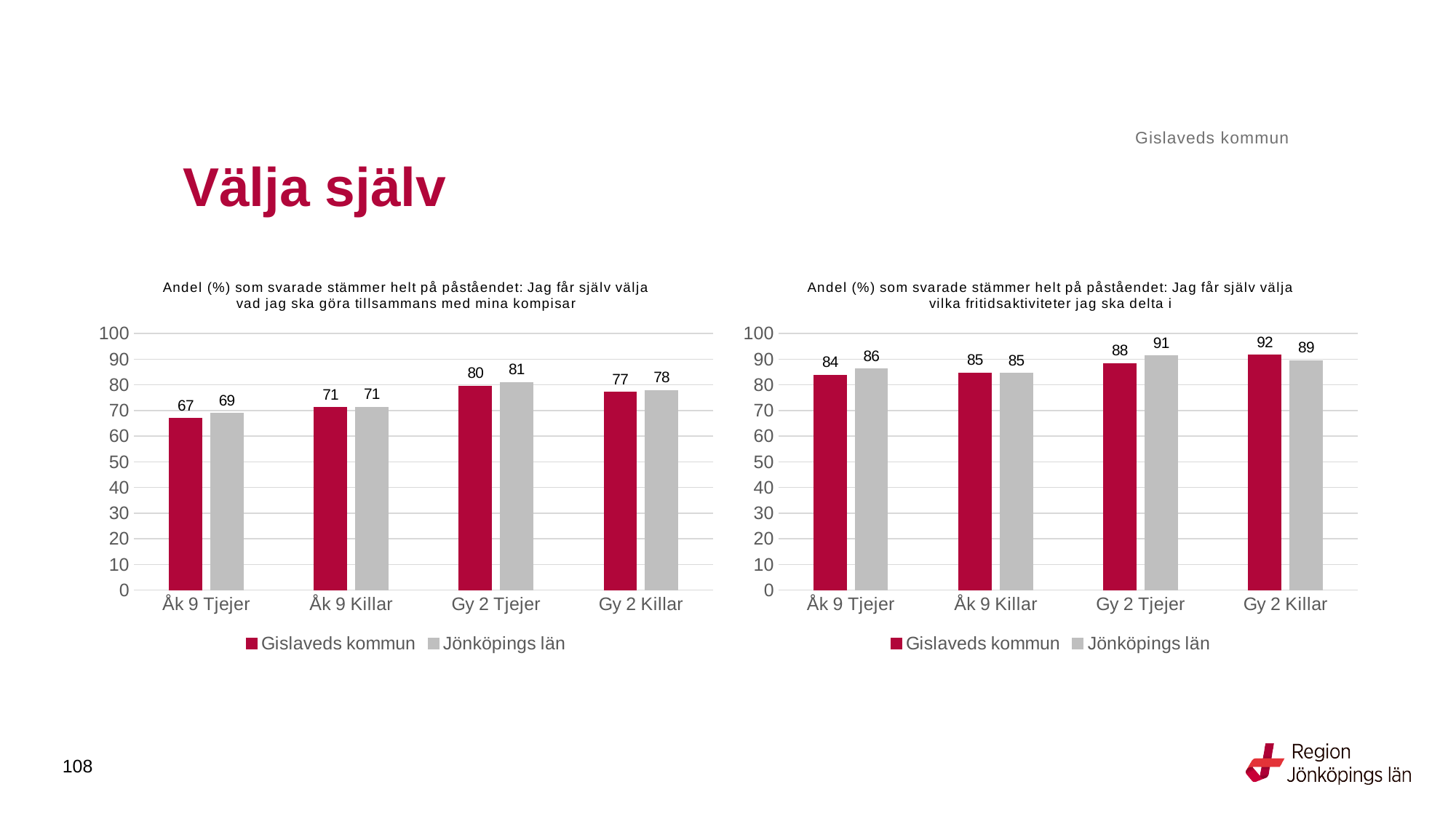
In the right chart (about choosing leisure activities), what is the value for Gislaveds kommun for Gy 2 Killar? 92 In the right chart (about choosing leisure activities), what is the difference between the Gislaveds kommun values for Gy 2 Killar and Åk 9 Tjejer? 8 In the right chart (about choosing leisure activities), what is the value for Jönköpings län for Åk 9 Tjejer? 86 How many categories are shown on the x axis of the left chart? 4 In the left chart (about choosing what to do with friends), what is the difference between the Jönköpings län and Gislaveds kommun values for Åk 9 Tjejer? 2 In the right chart (about choosing leisure activities), which is larger for Gy 2 Killar: Gislaveds kommun or Jönköpings län? Gislaveds kommun In the left chart (about choosing what to do with friends), what is the value for Gislaveds kommun for Åk 9 Tjejer? 67 In the right chart (about choosing leisure activities), which category has the lowest value for Gislaveds kommun? Åk 9 Tjejer What kind of chart is the left chart? Bar chart In the left chart (about choosing what to do with friends), what is the value for Jönköpings län for Gy 2 Tjejer? 81 How many series does the legend of the right chart list? 2 In the left chart (about choosing what to do with friends), which category has the highest value for Gislaveds kommun? Gy 2 Tjejer